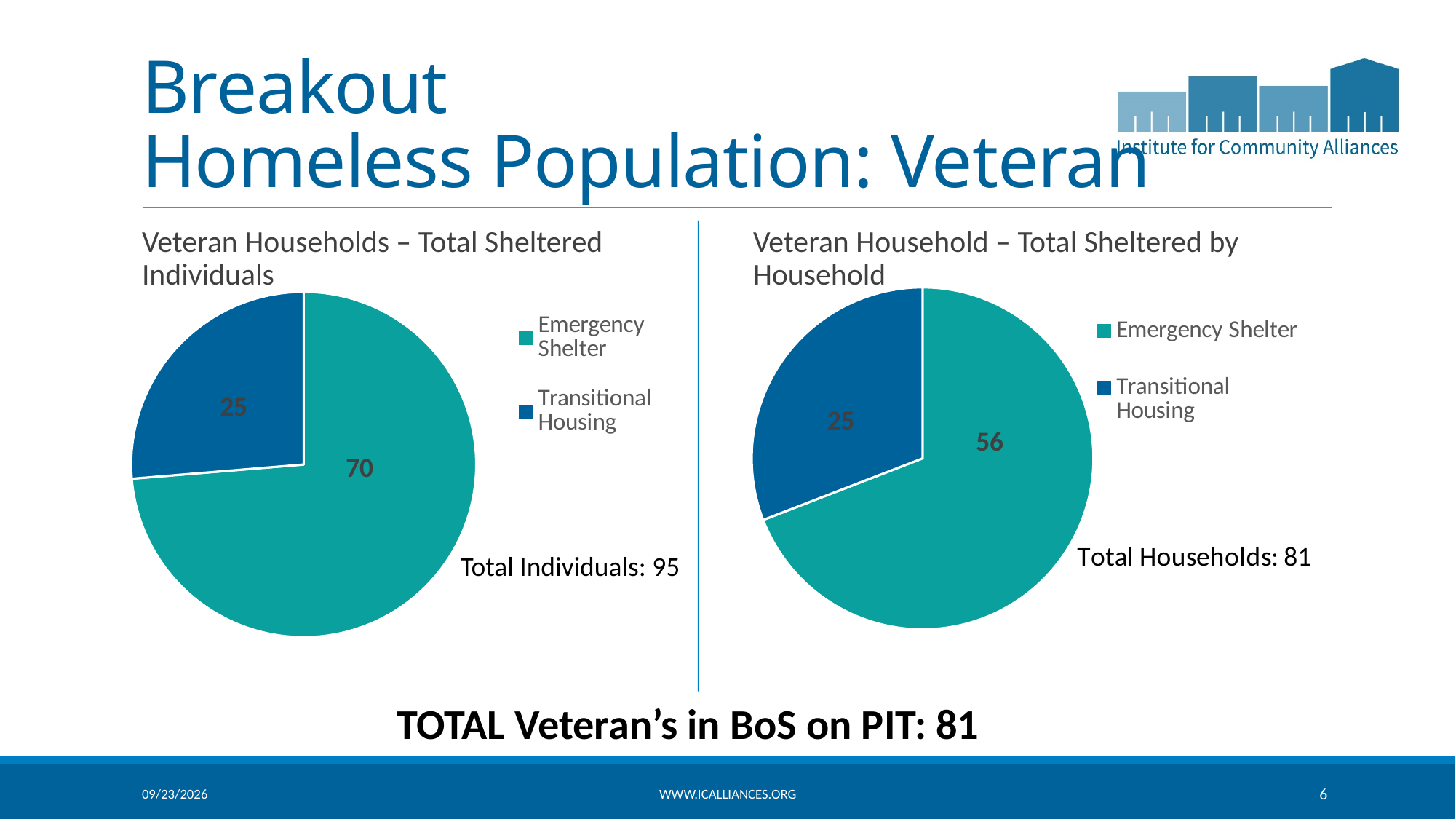
In the right chart (Veteran Household – Total Sheltered by Household), what is the value for Transitional Housing? 25 Is the Emergency Shelter value larger in the left chart (Total Sheltered Individuals) or the right chart (Total Sheltered by Household)? Left chart (Total Sheltered Individuals) In the left chart (Veteran Households – Total Sheltered Individuals), what is the value for Emergency Shelter? 70 In the right chart (Veteran Household – Total Sheltered by Household), what is the value for Emergency Shelter? 56 What type of chart is used on this slide? Pie chart In the right chart (Veteran Household – Total Sheltered by Household), what is the difference between Emergency Shelter and Transitional Housing? 31 What total is stated next to the left chart (Veteran Households – Total Sheltered Individuals)? Total Individuals: 95 In the left chart (Veteran Households – Total Sheltered Individuals), which category has the largest slice? Emergency Shelter In the right chart (Veteran Household – Total Sheltered by Household), which category has the smallest slice? Transitional Housing How many categories does the legend of the right chart (Veteran Household – Total Sheltered by Household) list? 2 In the left chart (Veteran Households – Total Sheltered Individuals), what is the difference between Emergency Shelter and Transitional Housing? 45 In the left chart (Veteran Households – Total Sheltered Individuals), what is the value for Transitional Housing? 25